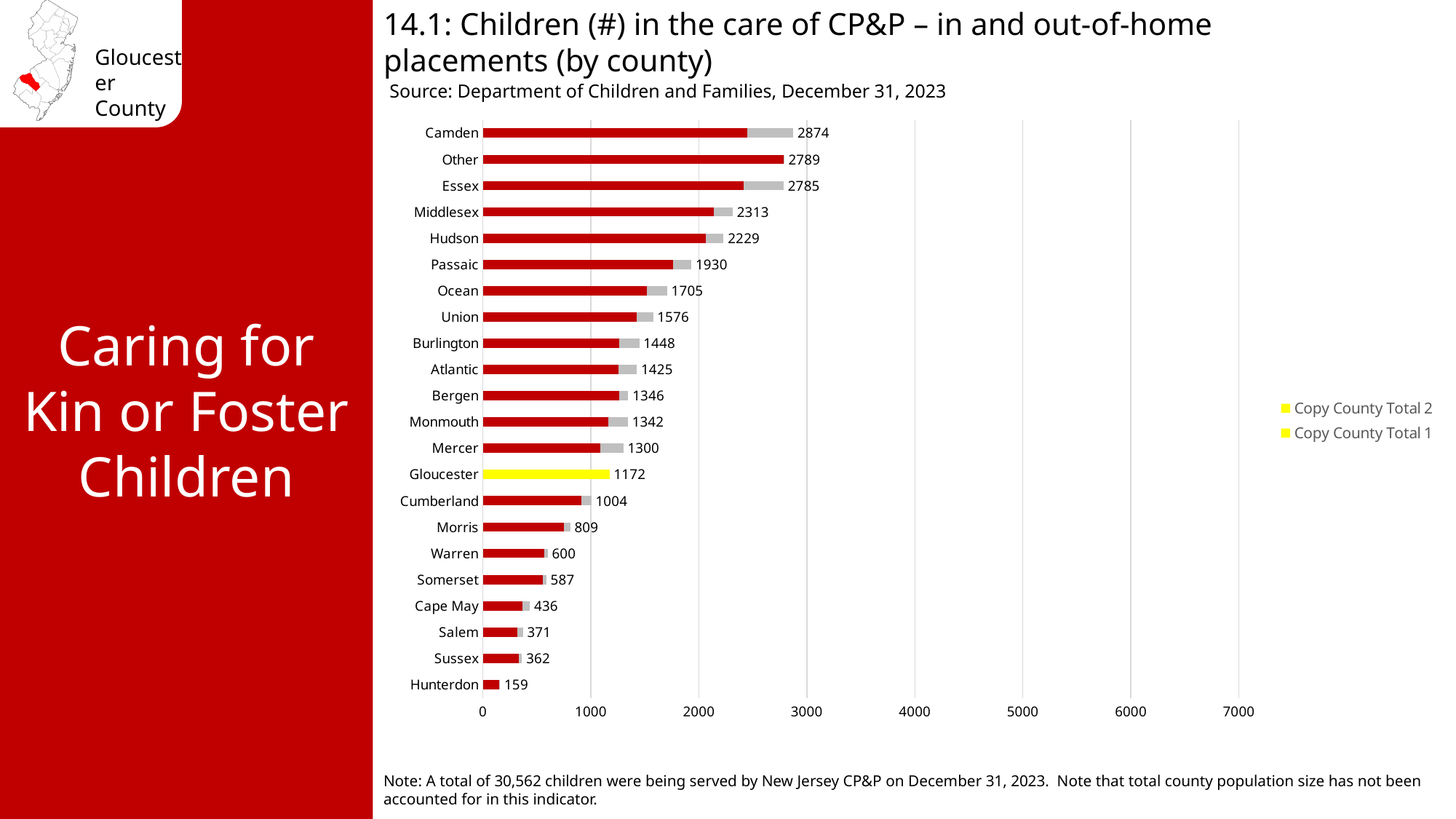
How many series does the legend list? 2 What is the total value shown for Hunterdon? 159 What kind of chart is shown on the slide? Bar chart Which county's bar is highlighted in yellow? Gloucester Which has a larger total, Passaic or Ocean? Passaic How many counties (categories) are shown on the chart? 22 Which county has the lowest total number of children in the care of CP&P? Hunterdon Which county has the highest total number of children in the care of CP&P? Camden Is the total for Middlesex greater or less than 2000? greater What is the difference between the totals for Camden and Gloucester? 1702 What is the total value shown for Camden? 2874 What is the total number of children in the care of CP&P for Gloucester? 1172